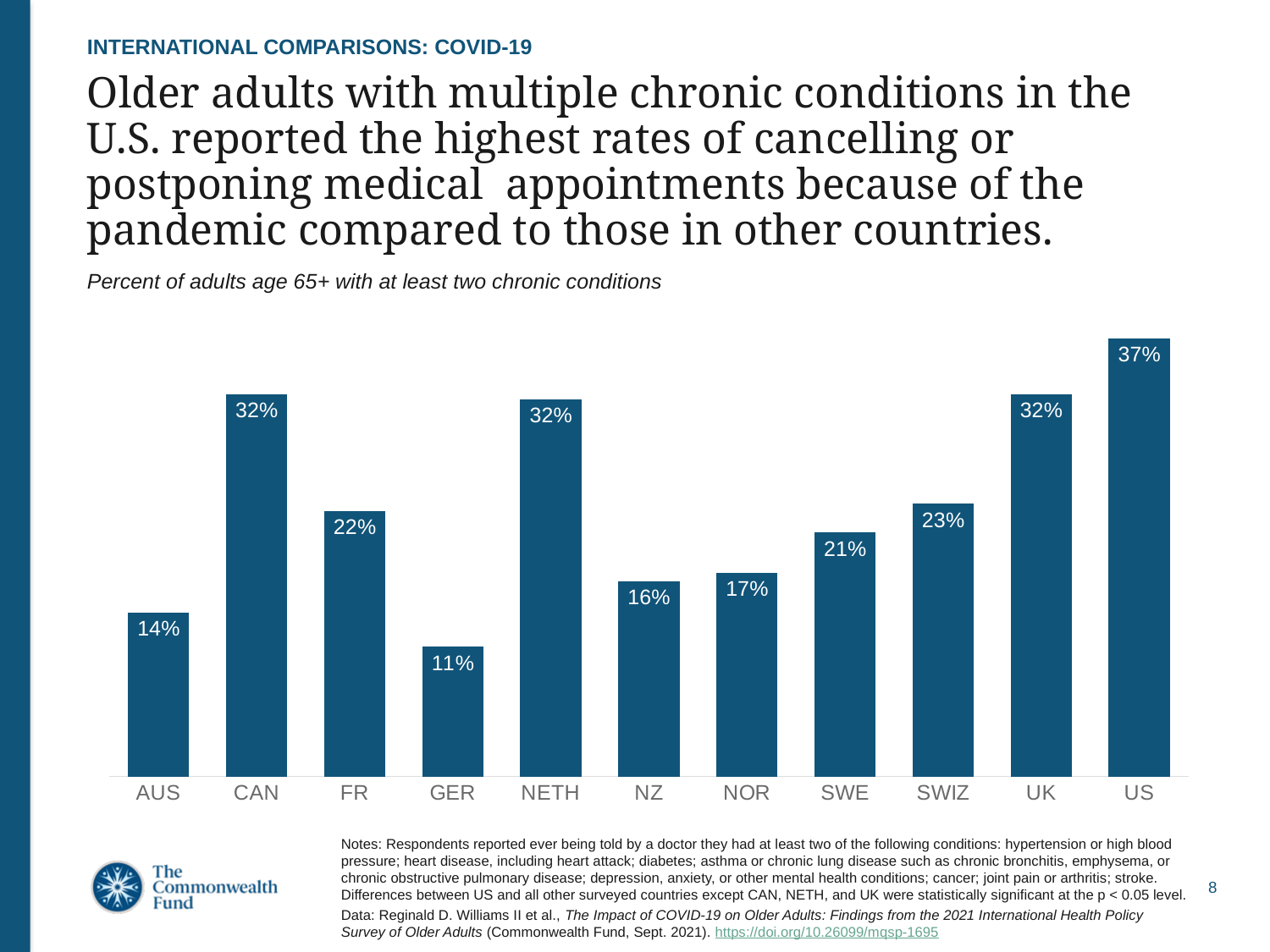
How many countries are shown in the chart? 11 Which country has the highest value? US What is the value for GER? 11% What is the difference between the values for the US and AUS? 23 percentage points What kind of chart is shown on the slide? Bar chart Which countries share a value of 32%? CAN, NETH, UK What is the value for SWE? 21% What does the chart's subtitle say is being measured? Percent of adults age 65+ with at least two chronic conditions What is the difference between the values for FR and NZ? 6 percentage points What is the value for the US? 37% Which is larger, the value for SWIZ or the value for NOR? SWIZ Which country has the lowest value? GER